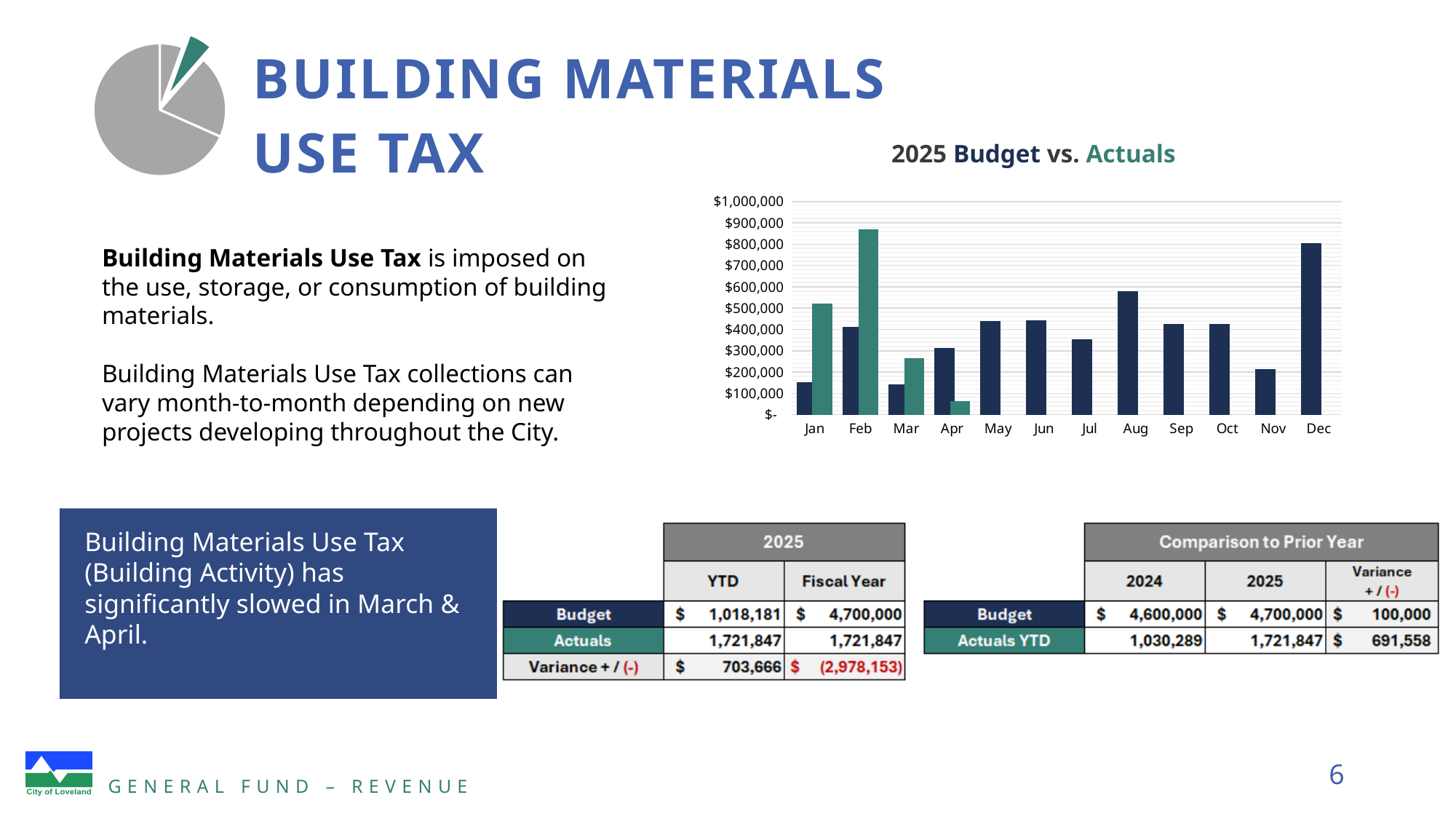
What kind of chart is the "2025 Budget vs. Actuals" chart? Bar chart In the "2025 Budget vs. Actuals" chart, which is larger for Apr: the Budget bar or the Actuals bar? Budget In the "2025 Budget vs. Actuals" chart, which month has the highest Actuals bar? Feb In the "2025 Budget vs. Actuals" chart, which month has the highest Budget bar? Dec In the "2025 Budget vs. Actuals" chart, which is larger for Feb: the Budget bar or the Actuals bar? Actuals In the "2025 Budget vs. Actuals" chart, is the Actuals value for Feb greater or less than $800,000? greater How many months are shown on the x axis of the "2025 Budget vs. Actuals" chart? 12 How many data series does the "2025 Budget vs. Actuals" chart plot? 2 In the "2025 Budget vs. Actuals" chart, which month has the lowest Actuals bar? Apr In the "2025 Budget vs. Actuals" chart, is the Budget value for Nov greater or less than $300,000? less In the "2025 Budget vs. Actuals" chart, how many months have an Actuals bar? 4 In the "2025 Budget vs. Actuals" chart, is the Actuals value for Apr greater or less than $100,000? less